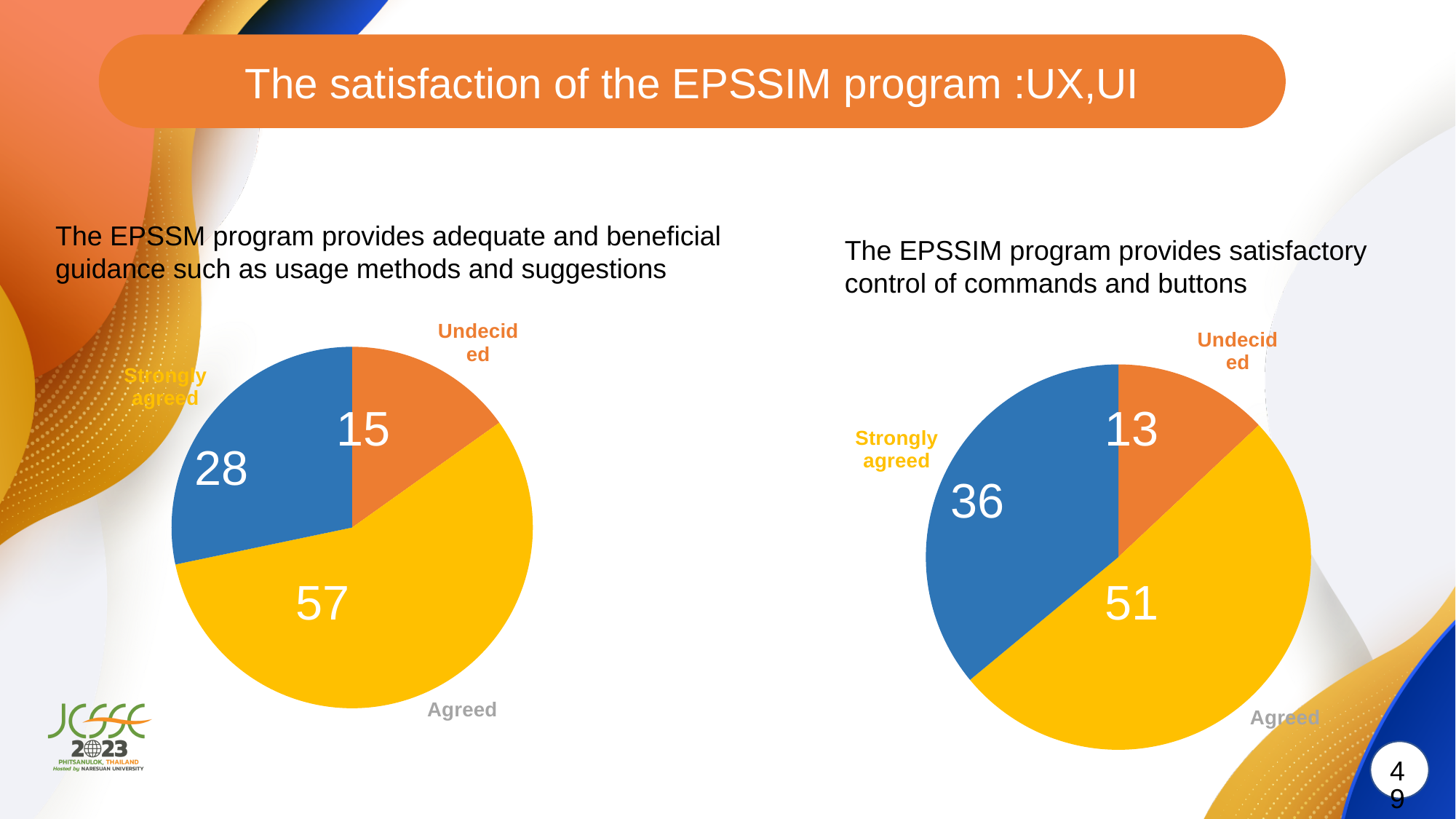
In the left pie chart (adequate and beneficial guidance), which category has the smallest slice? Undecided In the right pie chart (satisfactory control of commands and buttons), is Strongly agreed or Undecided larger? Strongly agreed In the left pie chart (adequate and beneficial guidance), what is the value for Strongly agreed? 28 In the right pie chart (satisfactory control of commands and buttons), what is the value for Undecided? 13 In the left pie chart, what colour is the Agreed slice? yellow What type of chart is shown on the left side of the slide? pie chart How many slices does the left pie chart have? 3 In the left pie chart (adequate and beneficial guidance), what is the value for Agreed? 57 In the left pie chart (adequate and beneficial guidance), what is the difference between Agreed and Strongly agreed? 29 In the right pie chart (satisfactory control of commands and buttons), what is the difference between Agreed and Strongly agreed? 15 In the right pie chart (satisfactory control of commands and buttons), what is the value for Strongly agreed? 36 In the right pie chart (satisfactory control of commands and buttons), which category has the largest slice? Agreed